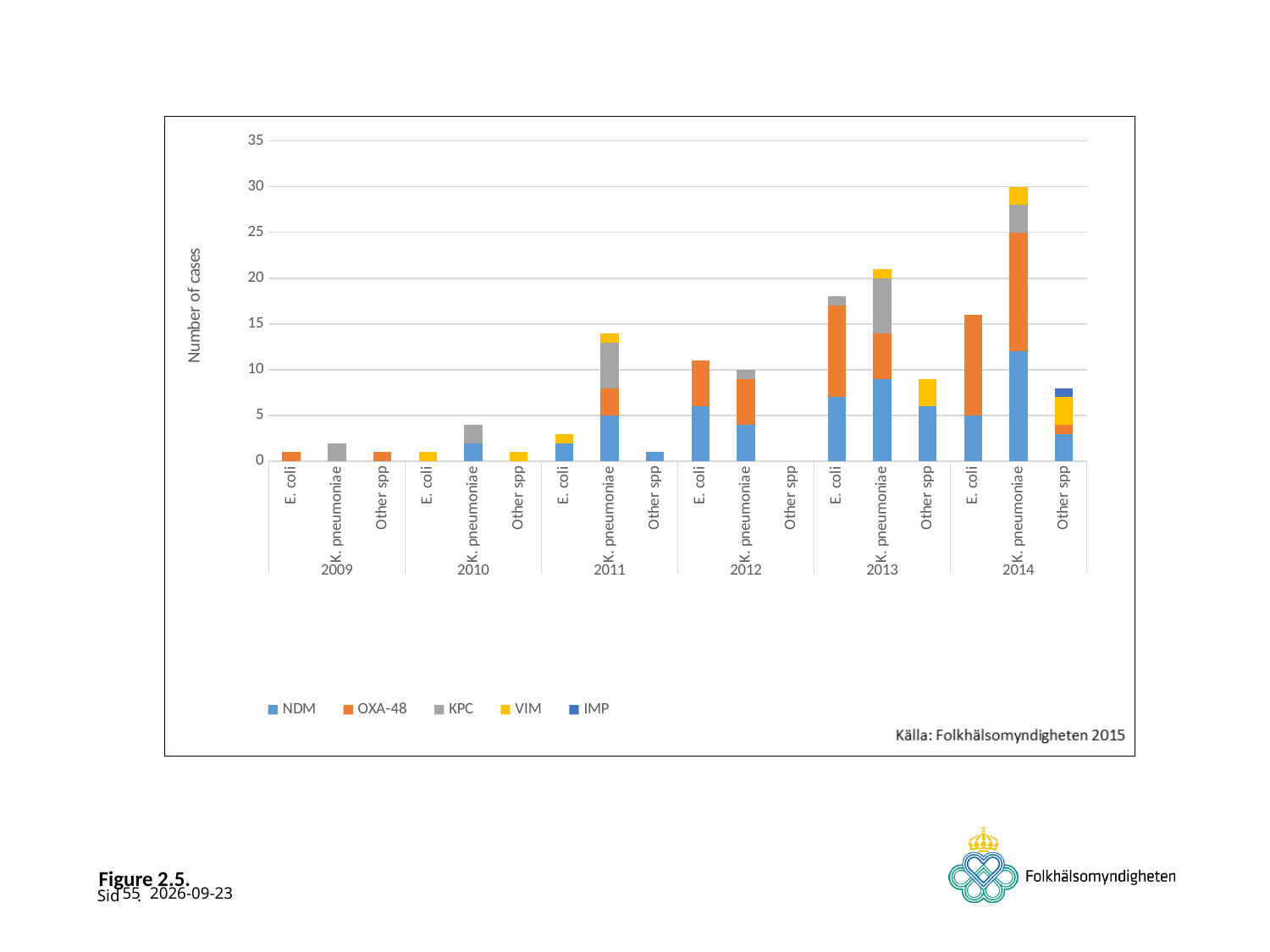
What is the label on the y axis? Number of cases Does the total for K. pneumoniae generally rise or fall from 2009 to 2014? rise How many series does the legend list? 5 Is the total for E. coli in 2011 greater or less than 5? less Is the total for K. pneumoniae in 2010 greater or less than 5? less Which category in 2012 has no bar at all? Other spp Is the total for K. pneumoniae in 2014 greater or less than 25? greater Which bar is the tallest in the chart? K. pneumoniae in 2014 How many years are shown along the x axis? 6 In 2014, which has the taller bar, E. coli or K. pneumoniae? K. pneumoniae What kind of chart is shown on the slide? Stacked bar chart